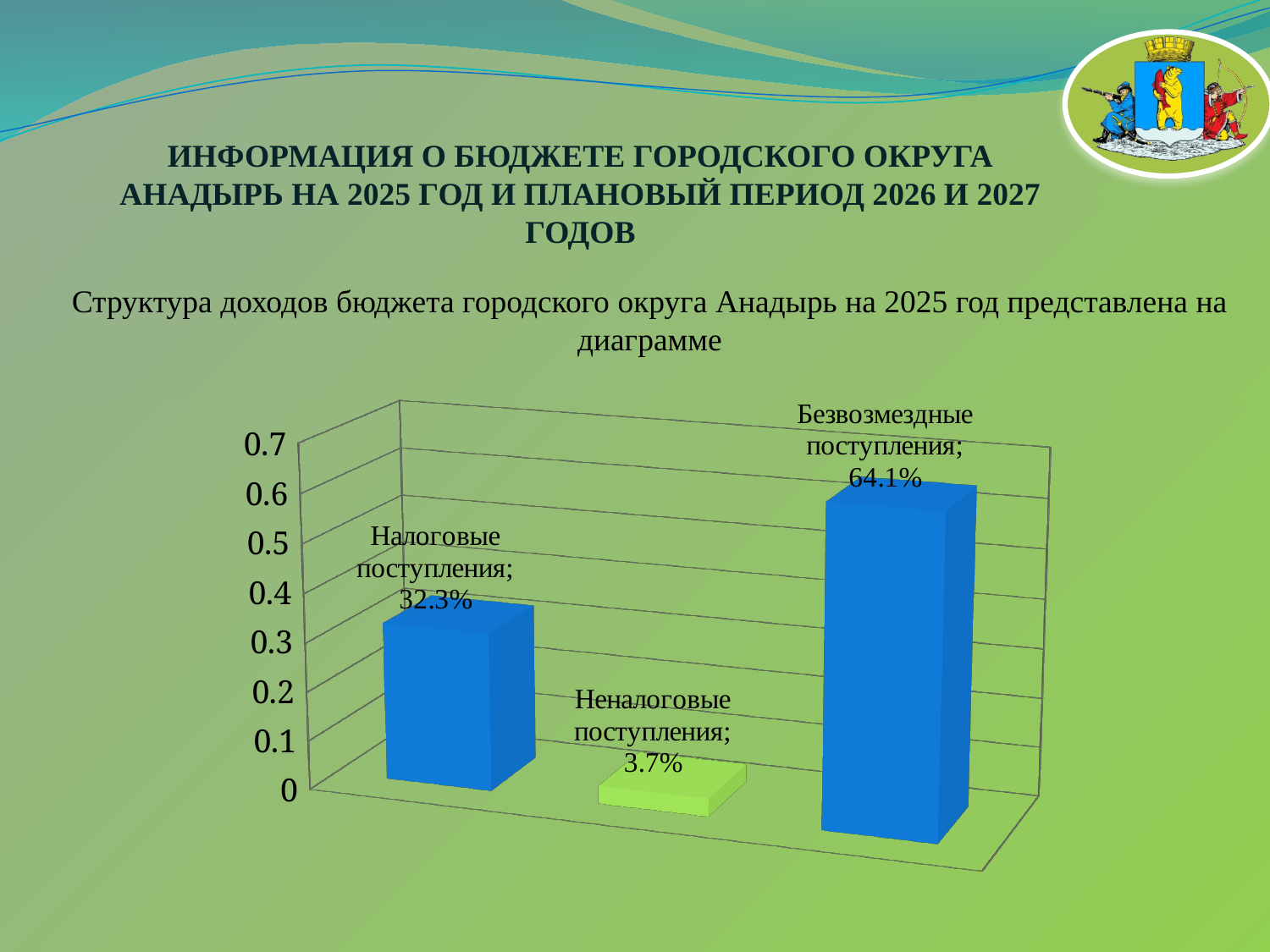
Is the value for Безвозмездные поступления greater or less than 0.5 on the axis? greater What is the difference between Безвозмездные поступления and Налоговые поступления? 31.8% What is the value for Неналоговые поступления? 3.7% How many categories are shown in the chart? 3 What is the value for Налоговые поступления? 32.3% Which category has the highest value? Безвозмездные поступления Which is larger, Налоговые поступления or Неналоговые поступления? Налоговые поступления Which category has the lowest value? Неналоговые поступления What kind of chart is shown on the slide? bar chart What is the value for Безвозмездные поступления? 64.1% What is the highest value shown on the vertical axis? 0.7 What is the difference between Налоговые поступления and Неналоговые поступления? 28.6%